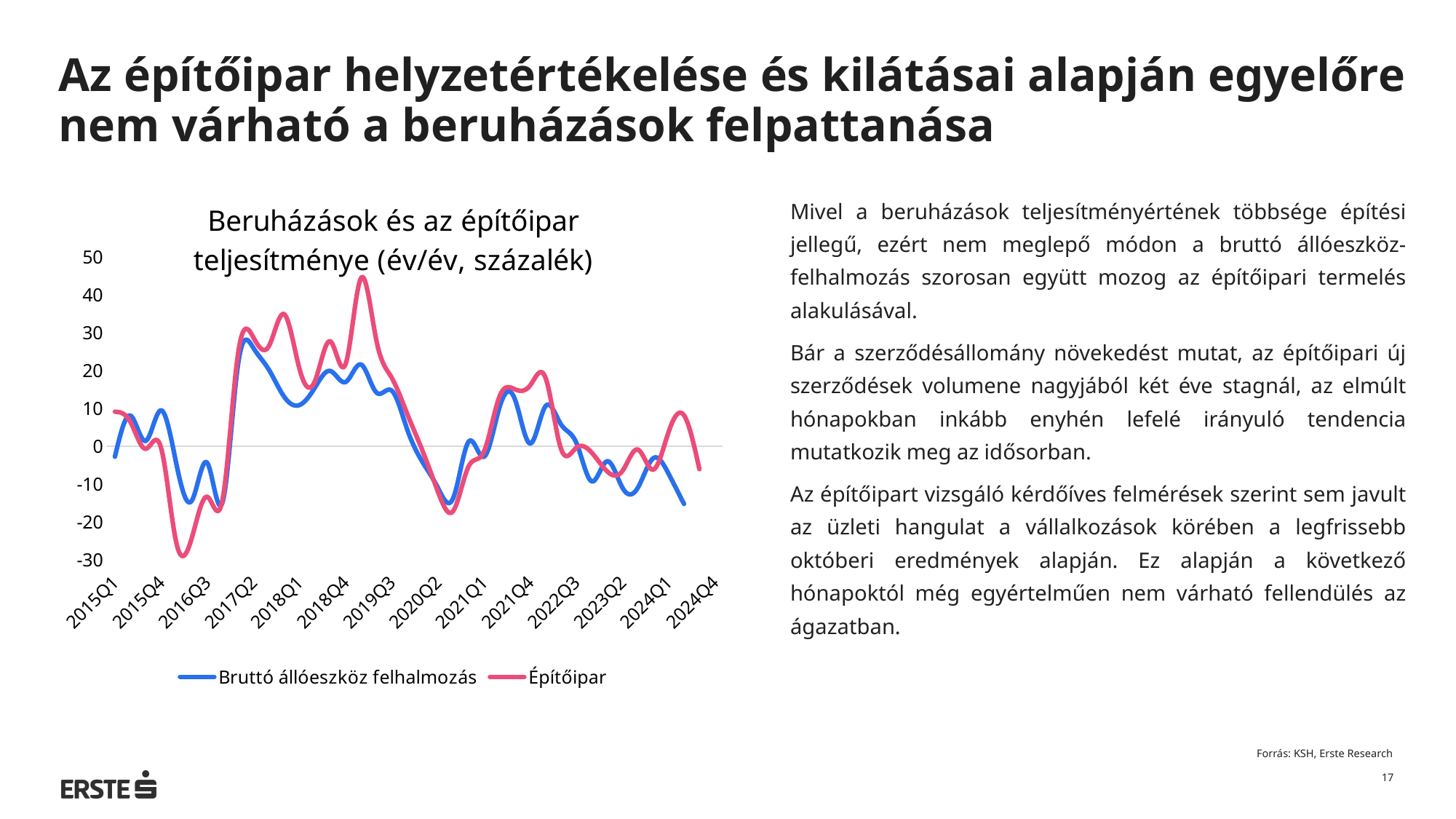
What is the title of the chart? Beruházások és az építőipar teljesítménye (év/év, százalék) Around 2019Q1, which series has the higher value, Bruttó állóeszköz felhalmozás or Építőipar? Építőipar Which series is drawn in pink in the chart? Építőipar What kind of chart is shown on the slide? Line chart How many series does the legend of the chart list? 2 Which series reaches the highest value anywhere in the chart? Építőipar Is the lowest value of the Építőipar series (around 2016) greater or less than -20? less Which series reaches the lowest value anywhere in the chart? Építőipar Is the peak value of the Építőipar series greater or less than 40? greater How many labels are shown on the x axis of the chart? 14 Does the Bruttó állóeszköz felhalmozás series rise or fall between 2016Q3 and 2017Q2? rise